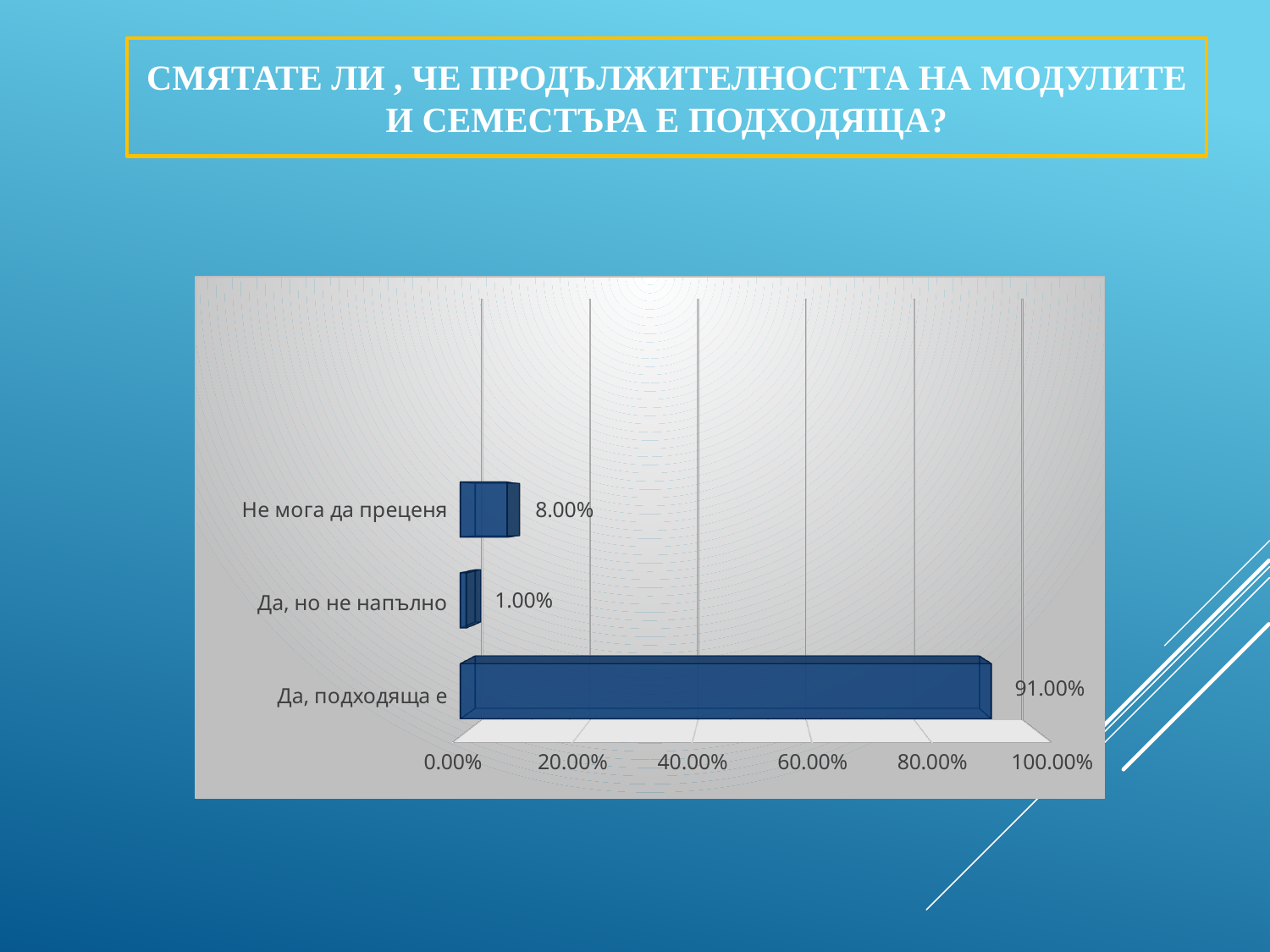
Which is larger, the value for "Не мога да преценя" or the value for "Да, но не напълно"? Не мога да преценя What kind of chart is shown on the slide? bar chart What is the difference between the values for "Не мога да преценя" and "Да, но не напълно"? 7.00% What is the value for "Да, подходяща е"? 91.00% What is the value for "Да, но не напълно"? 1.00% Is the value for "Да, подходяща е" greater or less than 80.00%? greater Which category has the lowest value? Да, но не напълно Which category has the highest value? Да, подходяща е How many categories are shown in the chart? 3 What is the difference between the values for "Да, подходяща е" and "Не мога да преценя"? 83.00% What is the value for "Не мога да преценя"? 8.00% What is the title of the slide above the chart? СМЯТАТЕ ЛИ , ЧЕ ПРОДЪЛЖИТЕЛНОСТТА НА МОДУЛИТЕ И СЕМЕСТЪРА Е ПОДХОДЯЩА?